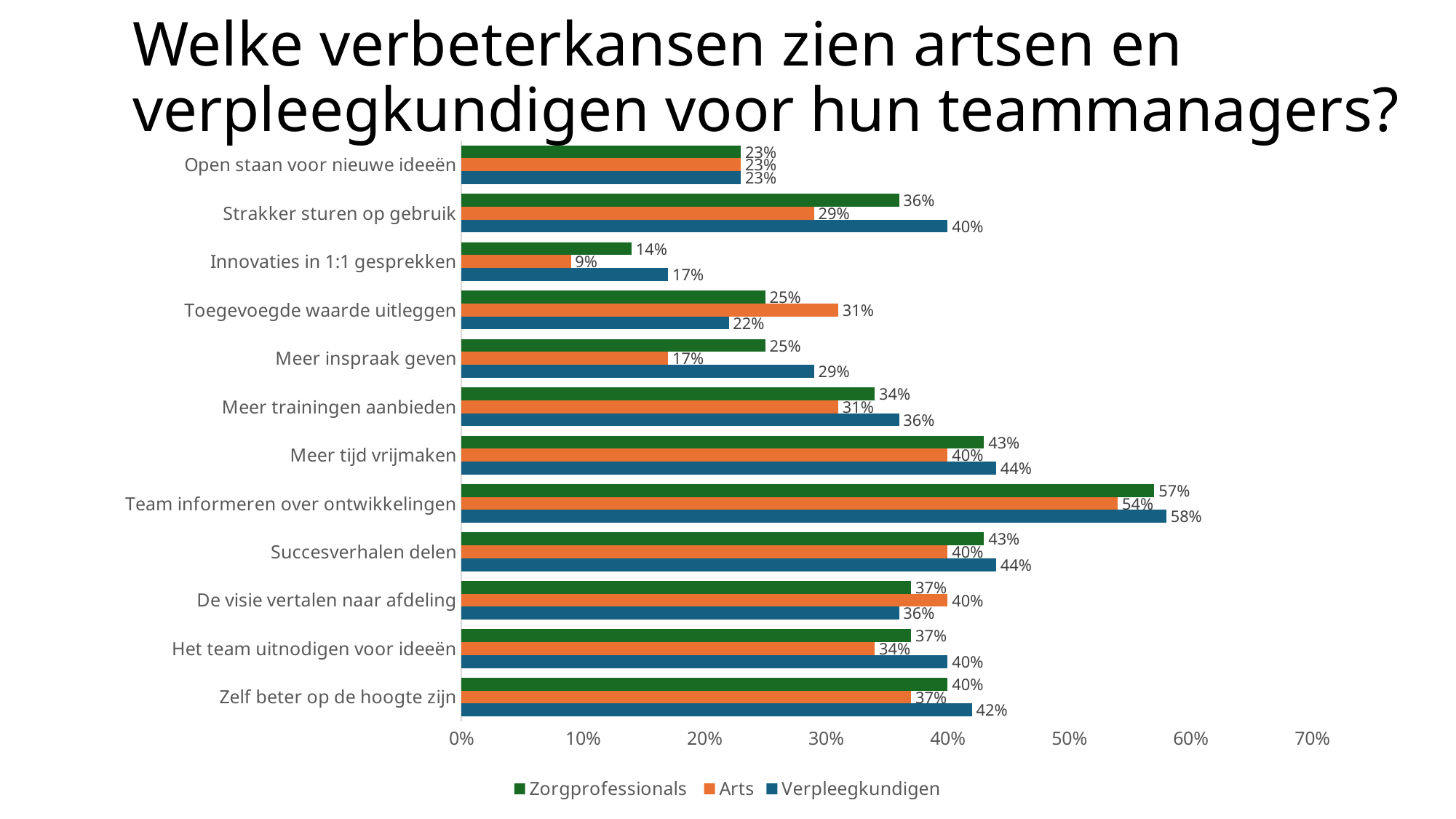
Which series is shown in orange in the legend? Arts For 'Toegevoegde waarde uitleggen', which series has the larger value: Arts or Verpleegkundigen? Arts What is the value for Arts for 'Innovaties in 1:1 gesprekken'? 9% What is the value for Zorgprofessionals for 'Strakker sturen op gebruik'? 36% Which category has the lowest value for Verpleegkundigen? Innovaties in 1:1 gesprekken What is the difference between the Verpleegkundigen and Arts values for 'Meer inspraak geven'? 12% Which category has the highest value for Arts? Team informeren over ontwikkelingen What type of chart is shown on the slide? bar chart Is the Zorgprofessionals value for 'Meer tijd vrijmaken' greater or less than 40%? greater What is the value for Verpleegkundigen for 'Team informeren over ontwikkelingen'? 58% How many series does the legend list? 3 How many categories are shown on the chart? 12